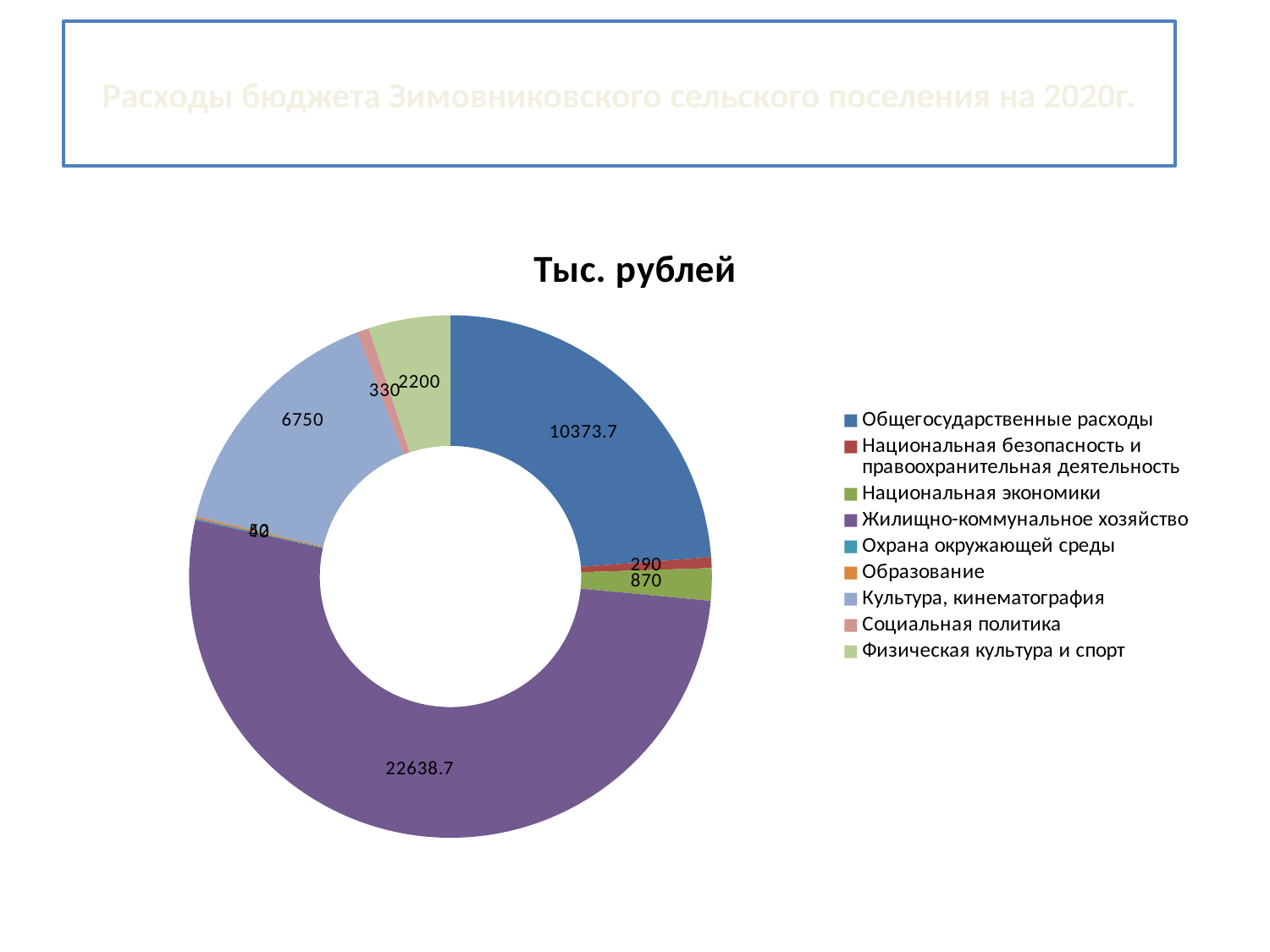
What is the difference between Культура, кинематография and Физическая культура и спорт? 4550 How many categories does the legend list? 9 What is the value for Национальная экономики? 870 What is the value for Культура, кинематография? 6750 What is the value for Общегосударственные расходы? 10373.7 Which category has the largest value? Жилищно-коммунальное хозяйство What is the value for Жилищно-коммунальное хозяйство? 22638.7 What is the value for Социальная политика? 330 Which is larger, Национальная экономики or Национальная безопасность и правоохранительная деятельность? Национальная экономики What is the difference between Жилищно-коммунальное хозяйство and Общегосударственные расходы? 12265 What is the title of the chart? Тыс. рублей What is the value for Физическая культура и спорт? 2200